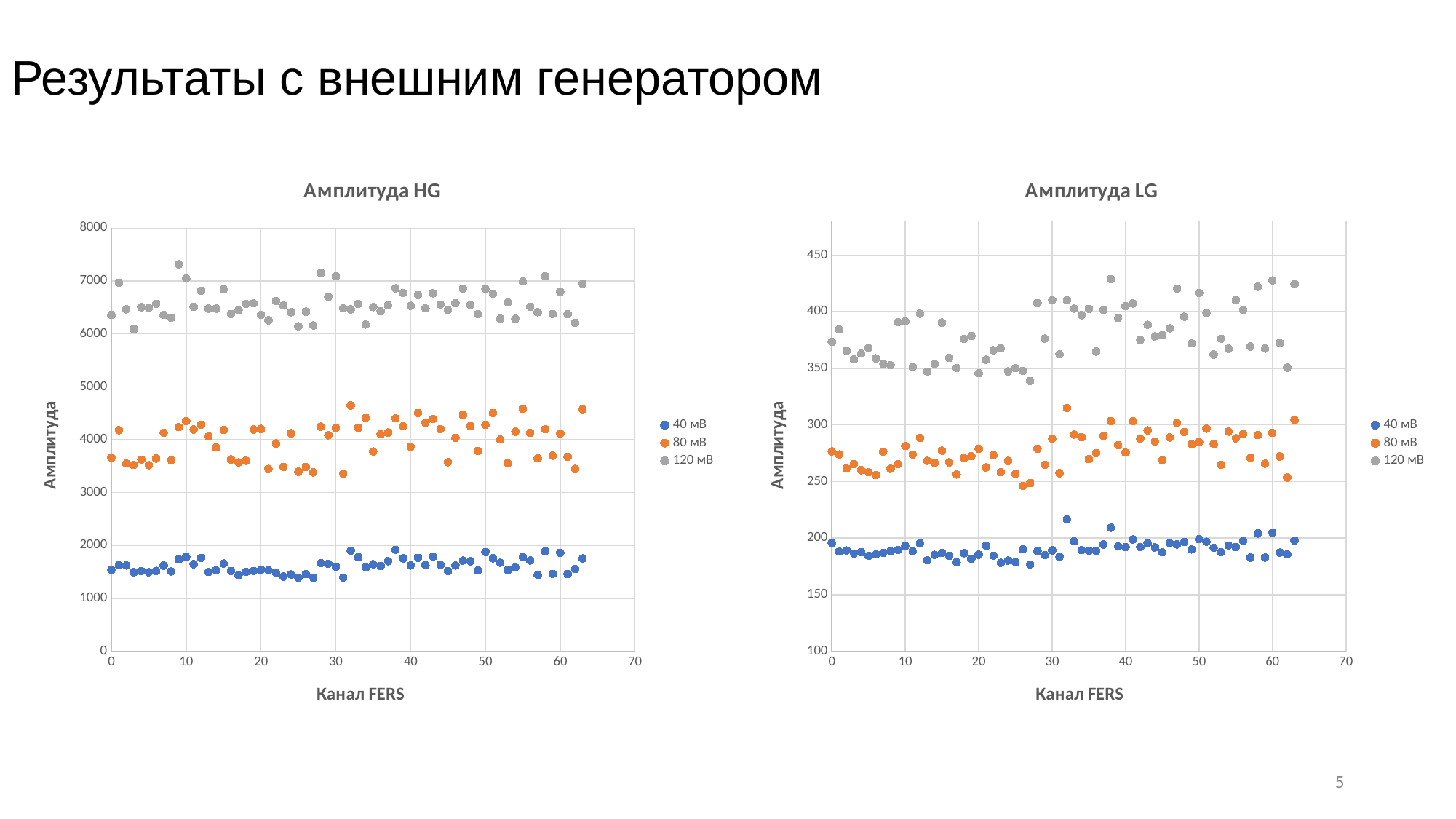
In the "Амплитуда LG" chart, are the values of the 80 мВ series greater or less than 200? greater In the "Амплитуда HG" chart, are the values of the 40 мВ series greater or less than 3000? less In the "Амплитуда LG" chart, are the values of the 120 мВ series greater or less than 450? less In the "Амплитуда LG" chart, which series has the lowest values overall? 40 мВ How many series does the legend of the "Амплитуда LG" chart list? 3 In the "Амплитуда HG" chart, which series has the highest values overall? 120 мВ What are the legend entries of the "Амплитуда HG" chart? 40 мВ, 80 мВ, 120 мВ What is the x-axis title of the "Амплитуда LG" chart? Канал FERS What kind of chart is the "Амплитуда HG" chart? scatter chart In the "Амплитуда HG" chart, which series has larger values: 80 мВ or 40 мВ? 80 мВ In the "Амплитуда LG" chart, which series has larger values: 120 мВ or 80 мВ? 120 мВ